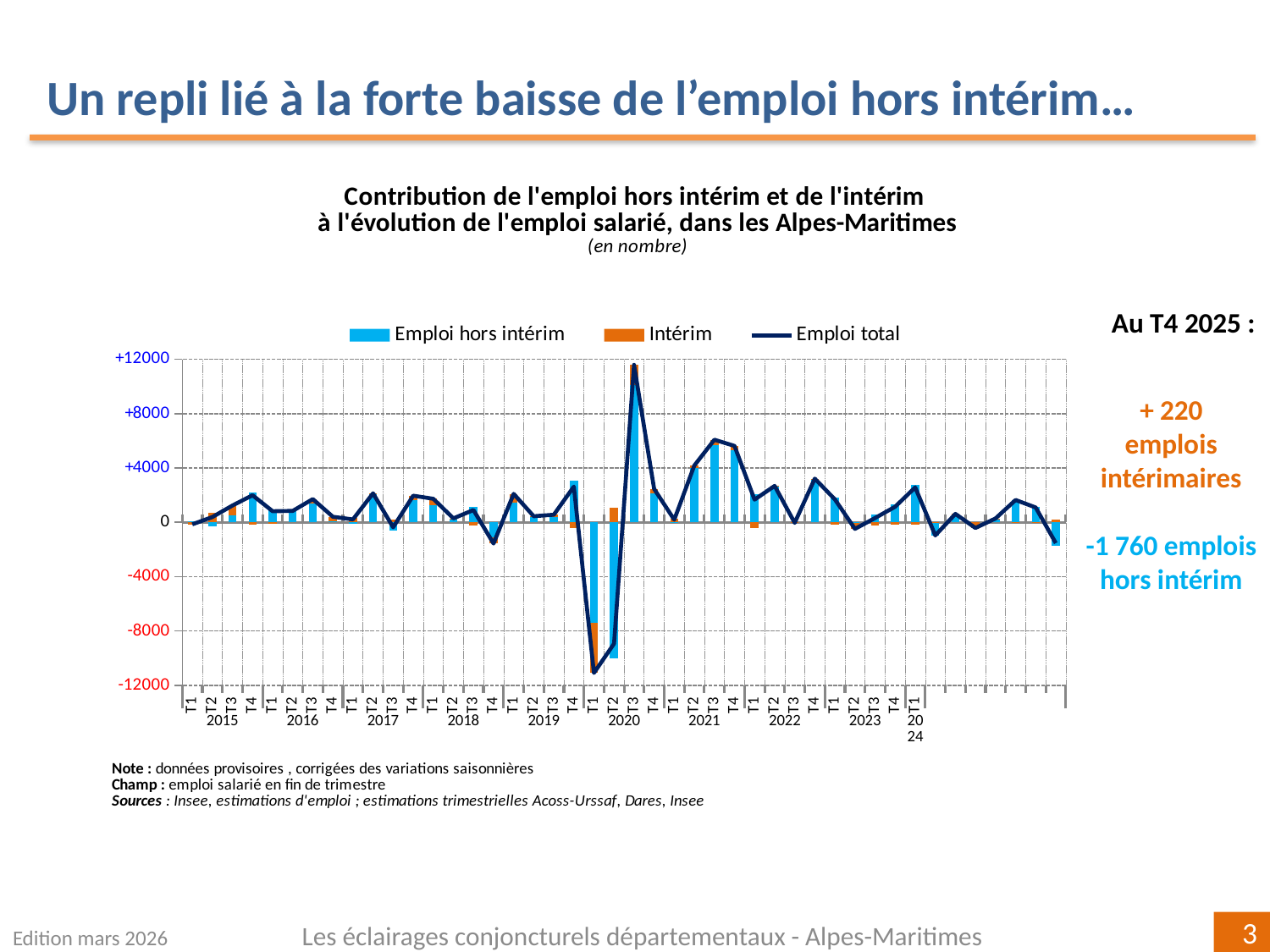
What are the three series listed in the chart legend? Emploi hors intérim, Intérim, Emploi total Which is larger, the Emploi total value at T3 2020 or at T3 2021? T3 2020 Between T1 2020 and T3 2020, does the Emploi total line rise or fall? rise In which quarter does the Emploi total line reach its highest value? T3 2020 Is the value of Emploi total at T3 2020 greater or less than +8000? greater According to the slide, what is the contribution of intérim employment at T4 2025? + 220 According to the slide, what is the contribution of emploi hors intérim at T4 2025? -1 760 Is the value of Emploi total at T1 2020 greater or less than -8000? less What kind of chart is shown on the slide? A combined bar and line chart How many series does the chart legend list? 3 In which quarter does the Emploi total line reach its lowest value? T1 2020 Is the Emploi hors intérim bar at T3 2021 greater or less than +4000? greater